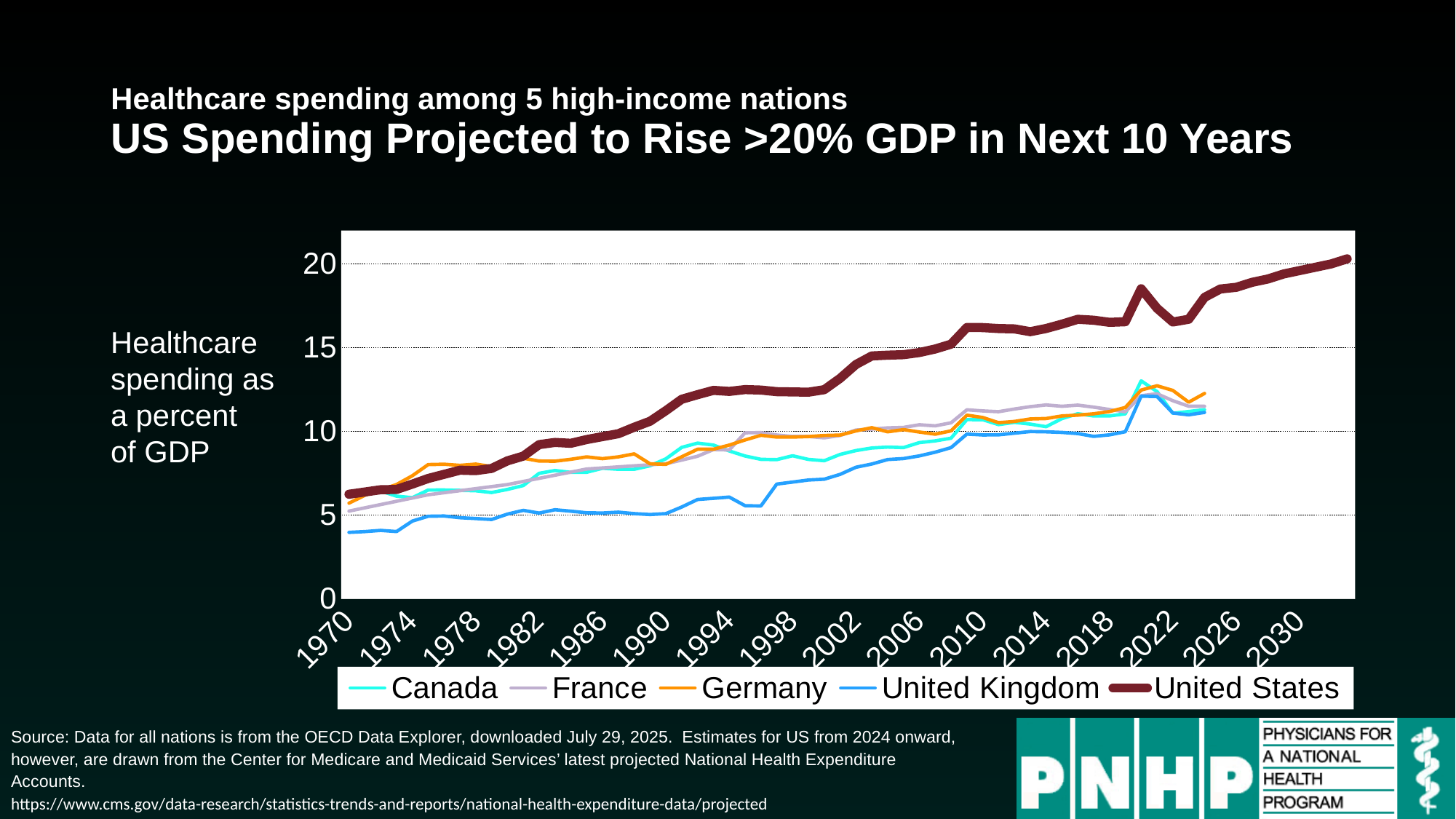
Does the United States line rise or fall from 1970 to 2030? rise Is the value for the United Kingdom in 1970 greater or less than 5? less What is the label on the y axis of the chart? Healthcare spending as a percent of GDP How many series does the legend list? 5 Which country has the highest healthcare spending as a percent of GDP in 2022? United States Is the value for the United States in 1970 greater or less than 10? less Which country has the lowest healthcare spending as a percent of GDP in 1970? United Kingdom Which countries are listed in the chart's legend? Canada, France, Germany, United Kingdom, United States How many year labels are shown on the x axis? 16 Is the value for the United States in 2030 greater or less than 15? greater What kind of chart is shown on the slide? line chart In 2010, which is larger: the value for the United States or the value for the United Kingdom? United States